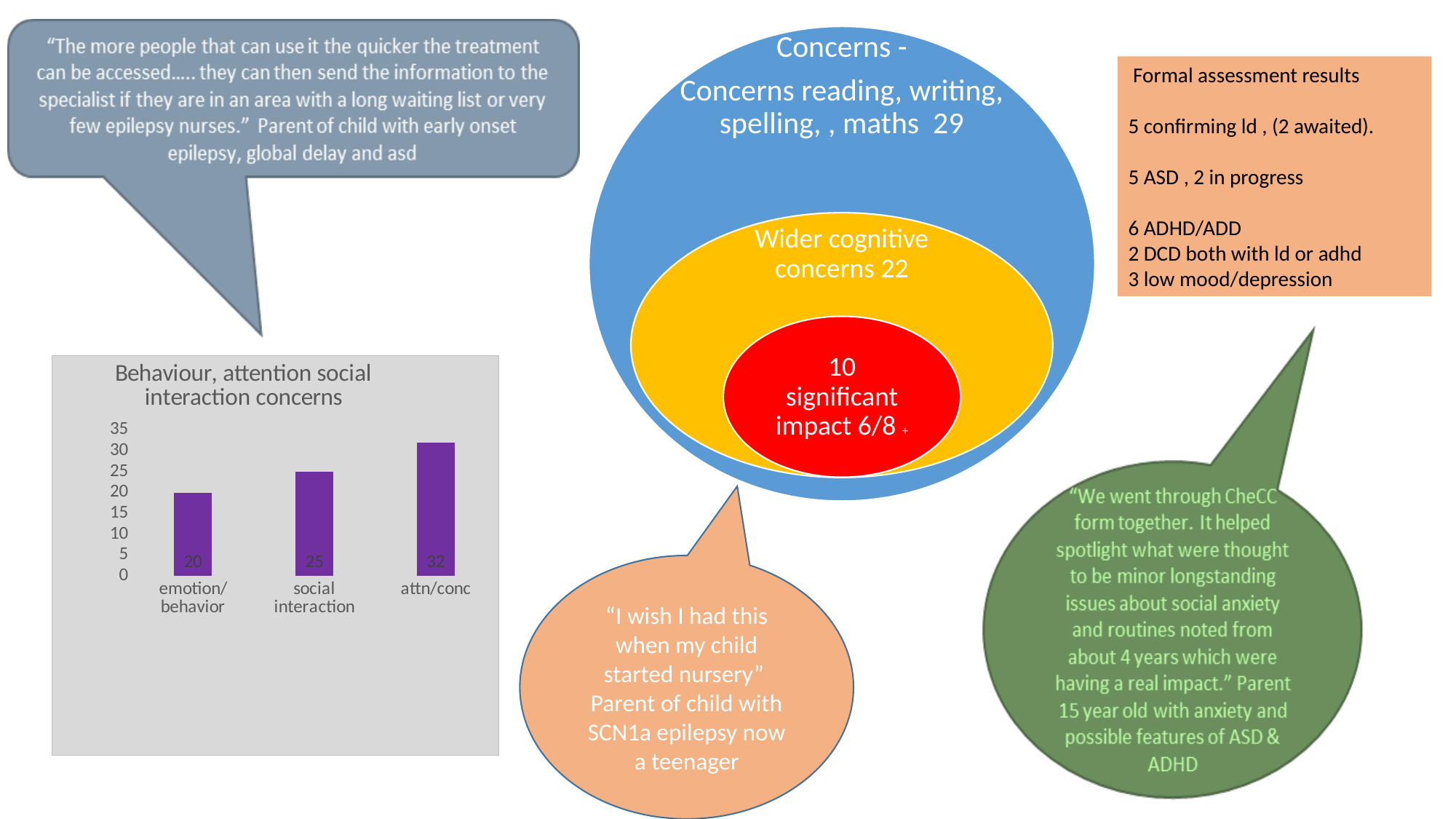
What is the value for attn/conc in the bar chart? 32 What kind of chart is shown on the slide? bar chart What is the value for social interaction in the bar chart? 25 What is the value for emotion/behavior in the bar chart? 20 Which category has the lowest value in the bar chart? emotion/behavior How many categories are shown in the bar chart? 3 What is the difference between the values for attn/conc and emotion/behavior? 12 What is the difference between the values for social interaction and emotion/behavior? 5 Which is larger, the value for social interaction or the value for emotion/behavior? social interaction Which category has the highest value in the bar chart? attn/conc What is the title of the bar chart? Behaviour, attention social interaction concerns Is the value for attn/conc greater or less than 30? greater